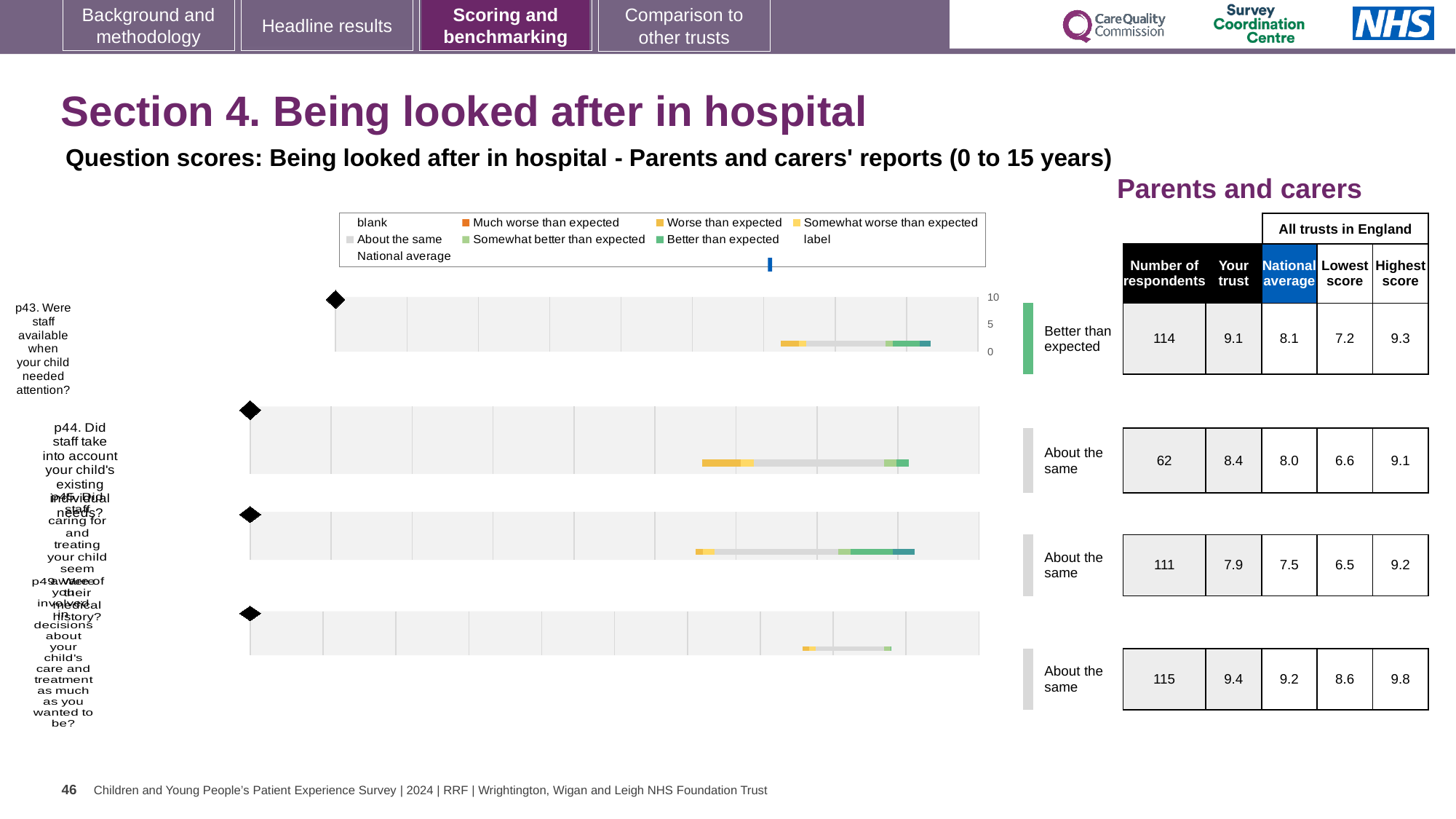
How many questions are plotted on the chart? 4 What is the national average score for p43 (Were staff available when your child needed attention?)? 8.1 Which question row has the highest 'Your trust' score? p49 What is the difference between the 'Your trust' score and the national average for p43? 1.0 What kind of chart is used to show the question scores? Bar chart Which has the higher 'Your trust' score, p43 or p44? p43 In the table, how many respondents are listed for p43 (Were staff available when your child needed attention?)? 114 Which question row has the lowest number of respondents? p44 What is the 'Your trust' score for p43 (Were staff available when your child needed attention?)? 9.1 What is the lowest score across all trusts in England for the third row (p45)? 6.5 Which question is rated 'Better than expected'? p43 What is the highest score across all trusts in England for the fourth row (p49)? 9.8